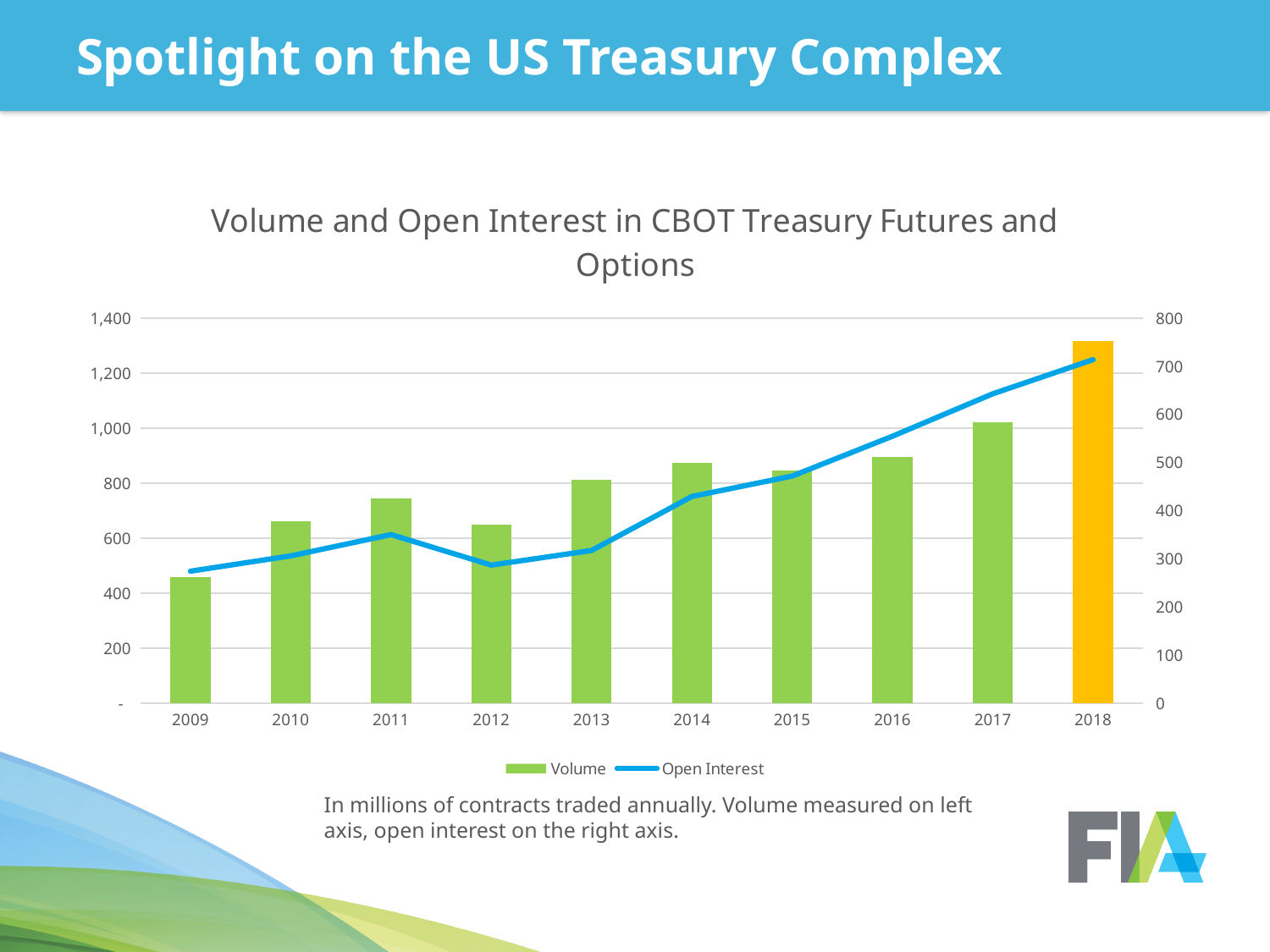
Which year has the highest Volume bar? 2018 How many series does the chart's legend list? 2 Does the Open Interest line rise or fall from 2013 to 2018? Rises Is the Volume value for 2018 greater or less than 1,200? greater Which year has the larger Volume bar, 2011 or 2012? 2011 Is the Volume value for 2009 greater or less than 600? less Which year's Volume bar is shown in a different colour (orange) from the others? 2018 How many years are shown on the x axis of the chart? 10 Is the Open Interest value for 2018 greater or less than 600 on the right axis? greater What kind of chart is shown on the slide? A combined bar and line chart Which year has the larger Volume bar, 2016 or 2017? 2017 Which year has the lowest Volume bar? 2009